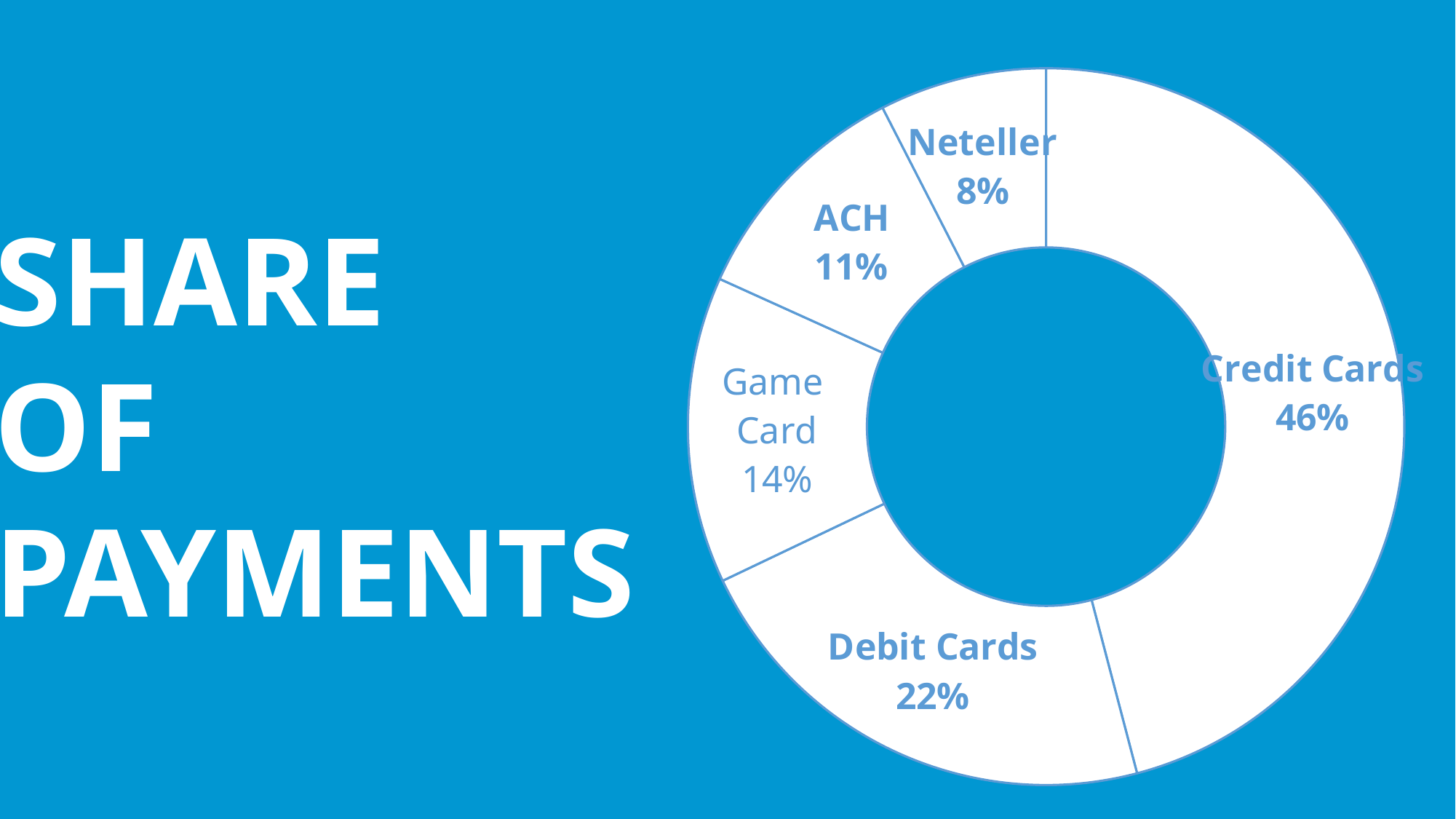
Which payment method has the smallest share? Neteller What share of payments do Debit Cards account for? 22% How many payment methods are shown in the chart? 5 What is the title of the slide? SHARE OF PAYMENTS What share of payments do Credit Cards account for? 46% Which has a larger share, Game Card or ACH? Game Card What kind of chart is shown on the slide? Doughnut (pie) chart Which payment method has the largest share? Credit Cards What share of payments does ACH account for? 11% What is the difference in share between Credit Cards and Debit Cards? 24% What share of payments does Neteller account for? 8% What share of payments does Game Card account for? 14%